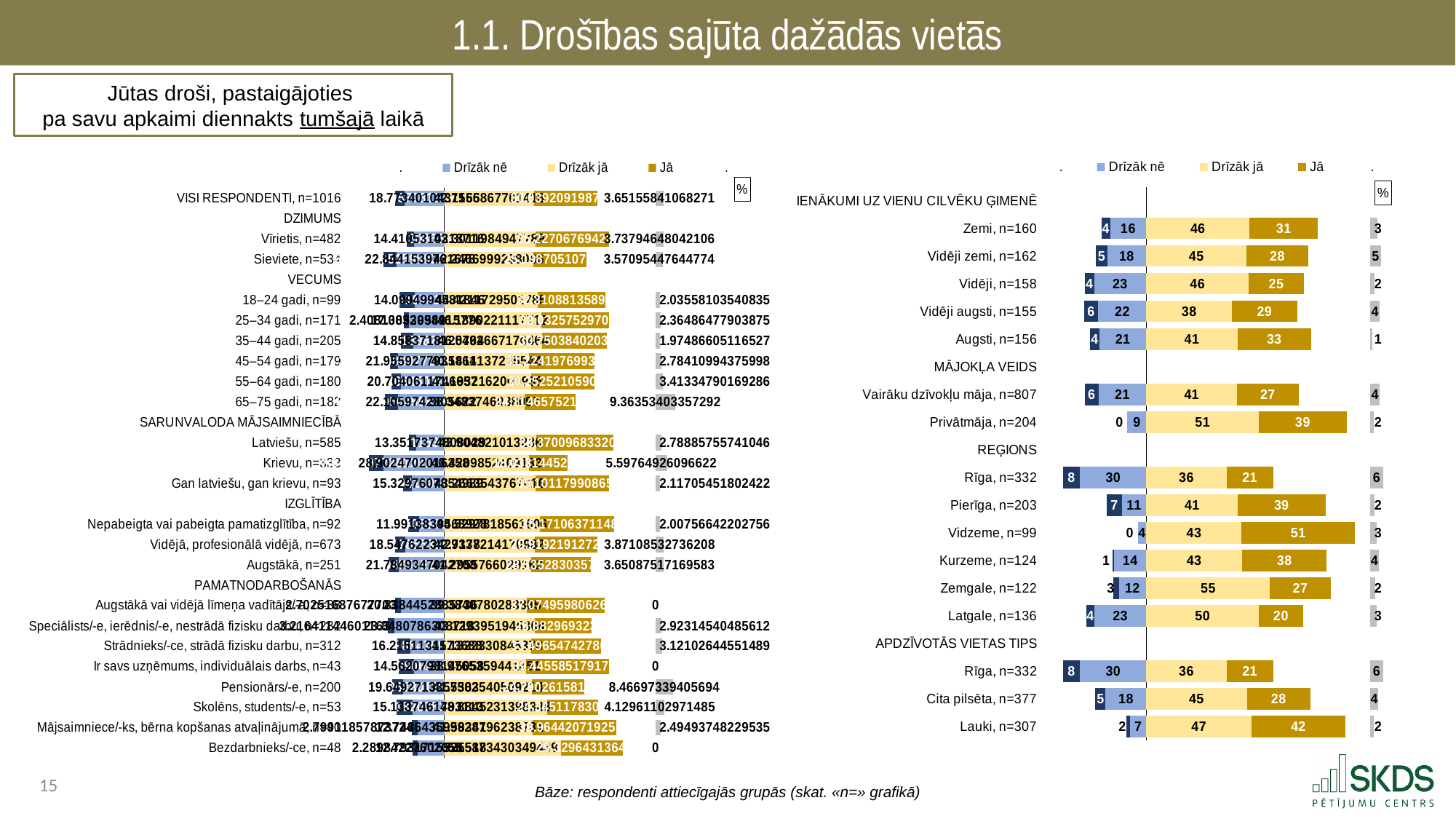
On the right chart, what is the "Jā" value for Privātmāja, n=204? 39 On the right chart, what is the combined "Drīzāk jā" and "Jā" value for Lauki, n=307? 89 On the right chart, which region under REĢIONS has the highest "Jā" value? Vidzeme, n=99 On the right chart, what is the "Drīzāk jā" value for Zemgale, n=122? 55 On the right chart, which has the larger "Drīzāk jā" value: Privātmāja, n=204 or Vairāku dzīvokļu māja, n=807? Privātmāja, n=204 How many series does the legend of the right chart list? 3 On the right chart, which region under REĢIONS has the lowest "Jā" value? Latgale, n=136 What are the legend entries of the right chart? Drīzāk nē, Drīzāk jā, Jā How many categories are shown under IENĀKUMI UZ VIENU CILVĒKU ĢIMENĒ on the right chart? 5 On the right chart, what is the "Drīzāk nē" value for Rīga, n=332? 30 What kind of chart is the right chart? Stacked bar chart On the right chart, what is the difference between the "Jā" values for Vidzeme, n=99 and Latgale, n=136? 31